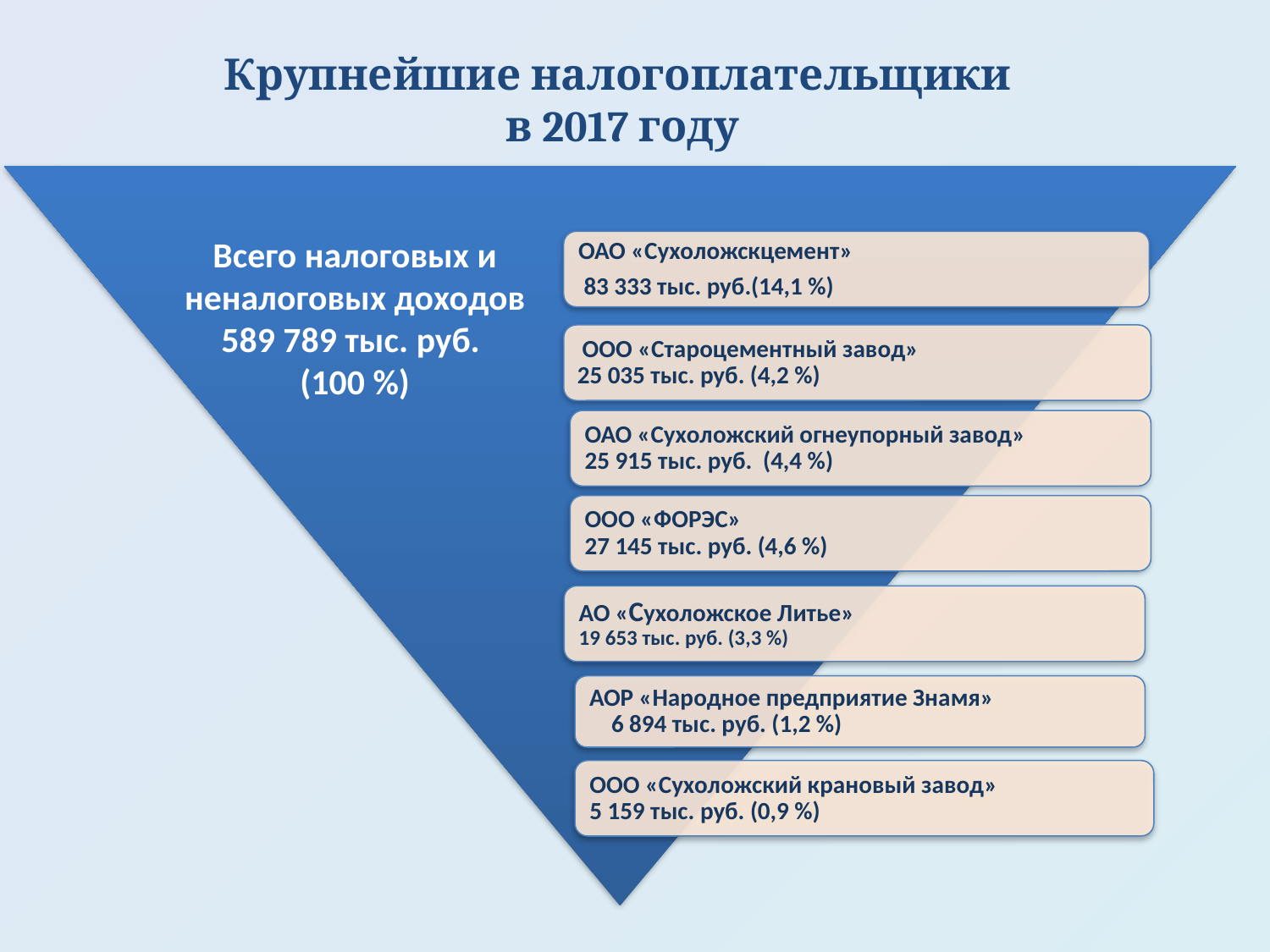
Which is larger, the amount for ООО «ФОРЭС» or for ООО «Староцементный завод»? ООО «ФОРЭС» What is the difference between the amounts for АОР «Народное предприятие Знамя» and ООО «Сухоложский крановый завод»? 1 735 тыс. руб. What percentage share is shown for АОР «Народное предприятие Знамя»? 1,2 % Which taxpayer has the smallest amount? ООО «Сухоложский крановый завод» What is the title of the slide? Крупнейшие налогоплательщики в 2017 году What total of tax and non-tax revenues is shown on the slide? 589 789 тыс. руб. What is the difference between the amounts for ОАО «Сухоложскцемент» and ООО «ФОРЭС»? 56 188 тыс. руб. What percentage share is shown for ООО «ФОРЭС»? 4,6 % What amount is shown for ОАО «Сухоложскцемент»? 83 333 тыс. руб. How many taxpayers are listed in the diagram? 7 Which taxpayer has the largest amount? ОАО «Сухоложскцемент» What amount is shown for АО «Сухоложское Литье»? 19 653 тыс. руб.